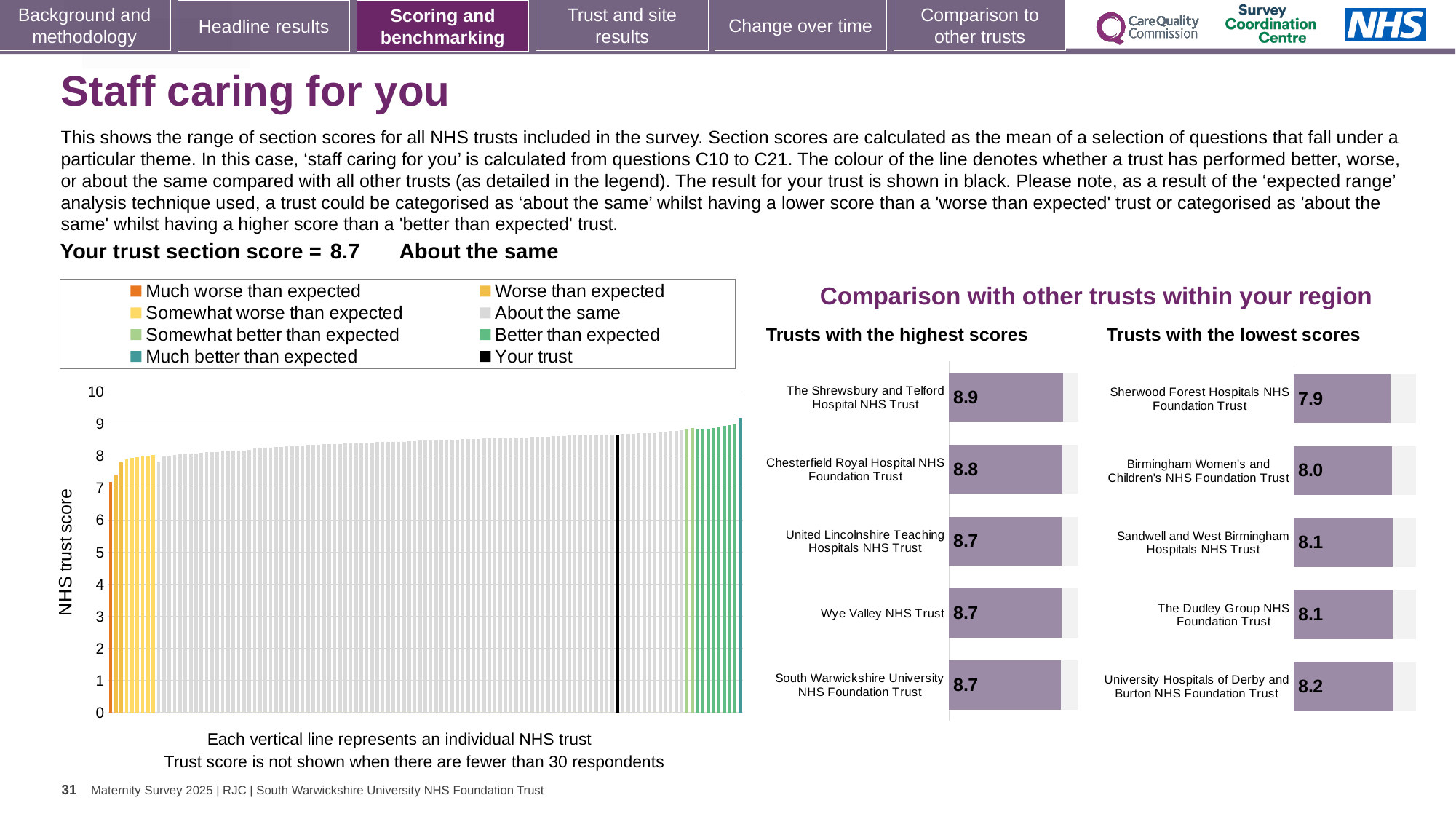
What kind of chart is the large chart on the left showing NHS trust scores? bar chart In the 'Trusts with the lowest scores' chart, which trust has the lowest score? Sherwood Forest Hospitals NHS Foundation Trust In the 'Trusts with the highest scores' chart, which trust has the highest score? The Shrewsbury and Telford Hospital NHS Trust In the large chart on the left, do the bar values rise or fall from left to right? rise In the 'Trusts with the lowest scores' chart, what is the score for Sherwood Forest Hospitals NHS Foundation Trust? 7.9 How many entries does the legend above the large chart on the left list? 8 In the large chart on the left, is the value of the leftmost (orange) bar greater or less than 8? less In the 'Trusts with the highest scores' chart, what is the score for The Shrewsbury and Telford Hospital NHS Trust? 8.9 How many trusts are listed in the 'Trusts with the lowest scores' chart? 5 In the 'Trusts with the highest scores' chart, what is the difference between the scores of The Shrewsbury and Telford Hospital NHS Trust and South Warwickshire University NHS Foundation Trust? 0.2 In the 'Trusts with the lowest scores' chart, which has the larger score: University Hospitals of Derby and Burton NHS Foundation Trust or Birmingham Women's and Children's NHS Foundation Trust? University Hospitals of Derby and Burton NHS Foundation Trust In the large chart on the left, what is the score shown by the black bar for your trust? 8.7